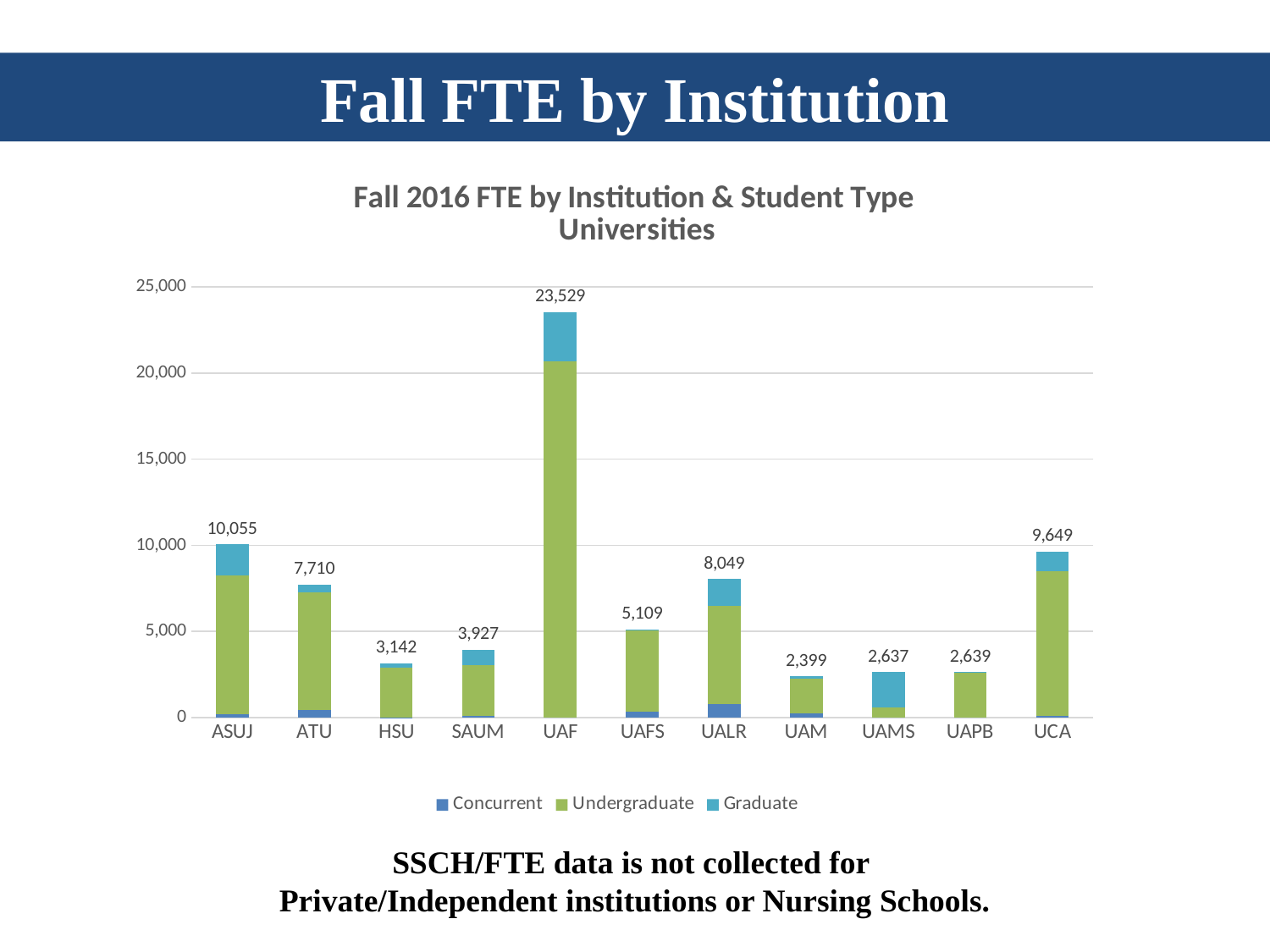
What is the total Fall 2016 FTE for UAF? 23,529 What is the total Fall 2016 FTE for UALR? 8,049 Which institution has the highest total FTE? UAF What is the difference between the total FTE for UAF and ASUJ? 13,474 Is the Undergraduate FTE for UAF greater or less than 20,000? greater How many series does the legend list? 3 What is the total Fall 2016 FTE for UAM? 2,399 What is the total Fall 2016 FTE for ASUJ? 10,055 What kind of chart is shown on the slide? Stacked bar chart How many institutions are shown on the x axis? 11 Which has a larger total FTE, ASUJ or UCA? ASUJ Which institution has the lowest total FTE? UAM